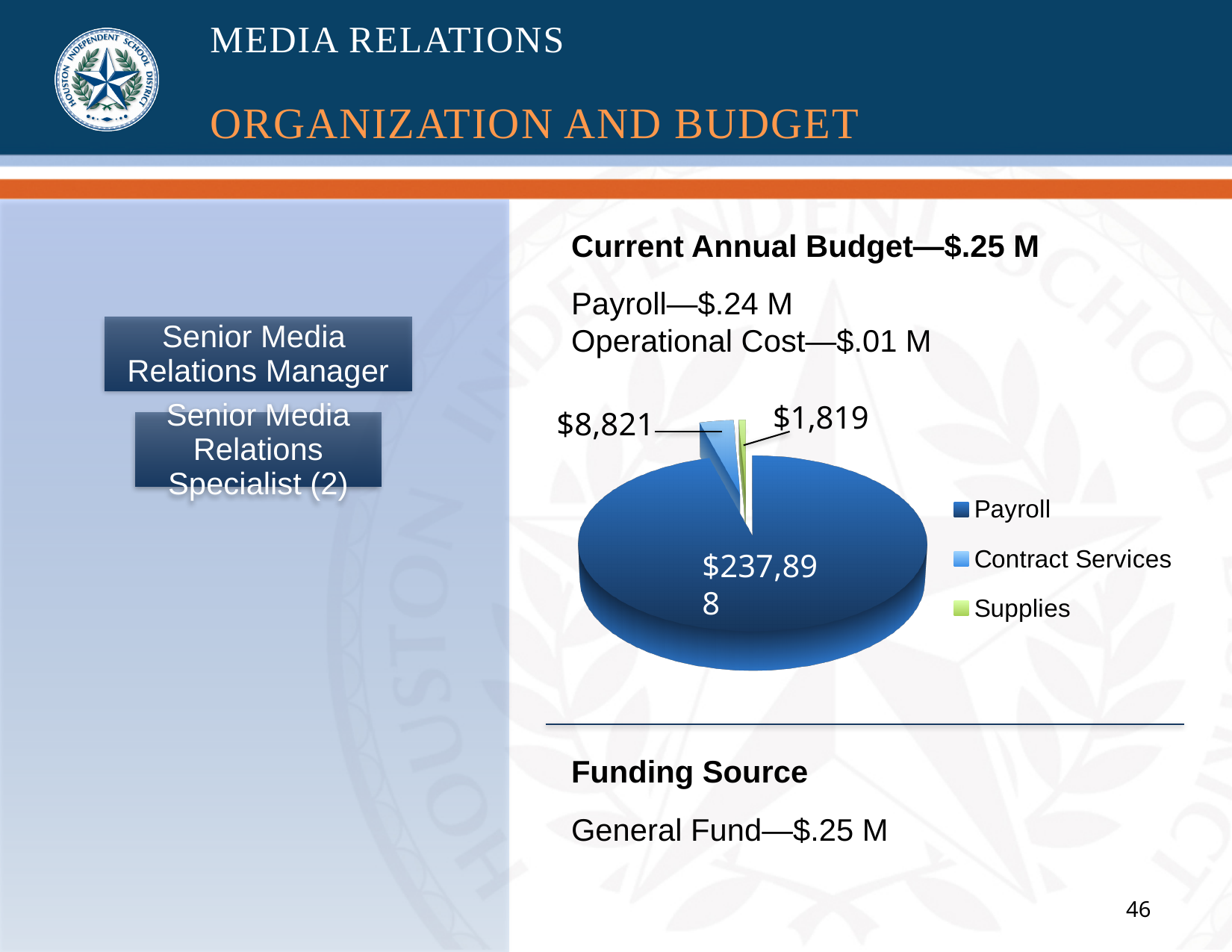
What is the value of the Contract Services slice in the pie chart? $8,821 Which category has the smallest slice in the pie chart? Supplies What kind of chart is shown on the slide? Pie chart Which is larger in the pie chart, Contract Services or Supplies? Contract Services Which category has the largest slice in the pie chart? Payroll What is the total of all three slices in the pie chart? $248,538 How many slices does the pie chart have? 3 How many entries does the pie chart's legend list? 3 What is the difference between the Payroll value and the Contract Services value in the pie chart? $229,077 What is the value of the Payroll slice in the pie chart? $237,898 What is the value of the Supplies slice in the pie chart? $1,819 What is the difference between the Contract Services value and the Supplies value in the pie chart? $7,002